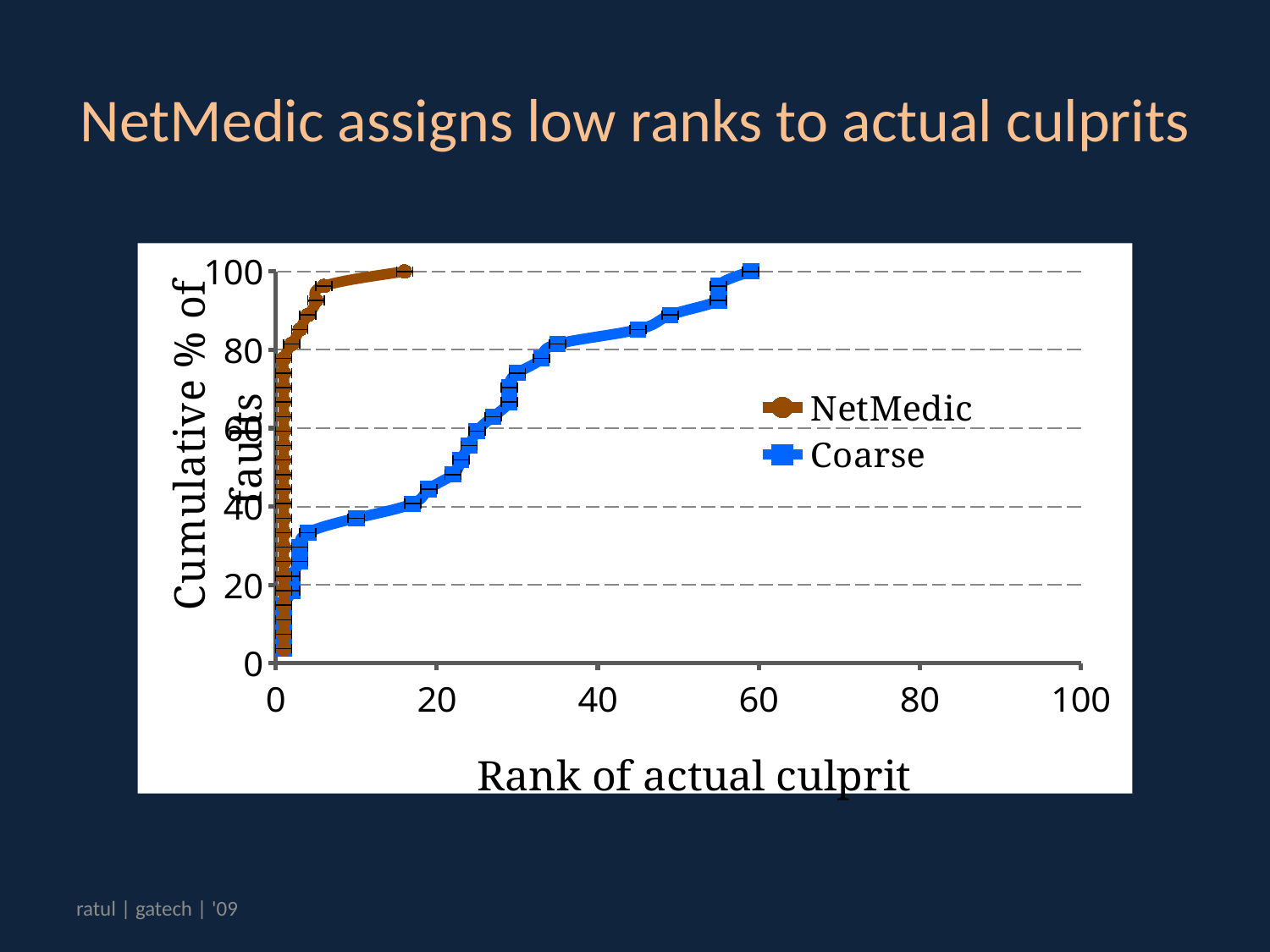
Is the cumulative % of faults for Coarse at rank 40 greater or less than 60? greater Which series reaches 100% cumulative faults at a lower rank, NetMedic or Coarse? NetMedic How many series does the legend list? 2 Is the cumulative % of faults for Coarse at rank 20 greater or less than 60? less What is the maximum cumulative % of faults reached by the NetMedic series? 100 Is the cumulative % of faults for NetMedic at rank 10 greater or less than 80? greater What are the two series named in the legend? NetMedic and Coarse Do the values of the Coarse series rise or fall as the rank increases along the x axis? rise At a rank of 20, which series has the higher cumulative % of faults, NetMedic or Coarse? NetMedic What kind of chart is shown on the slide? line chart What is the label of the x axis? Rank of actual culprit